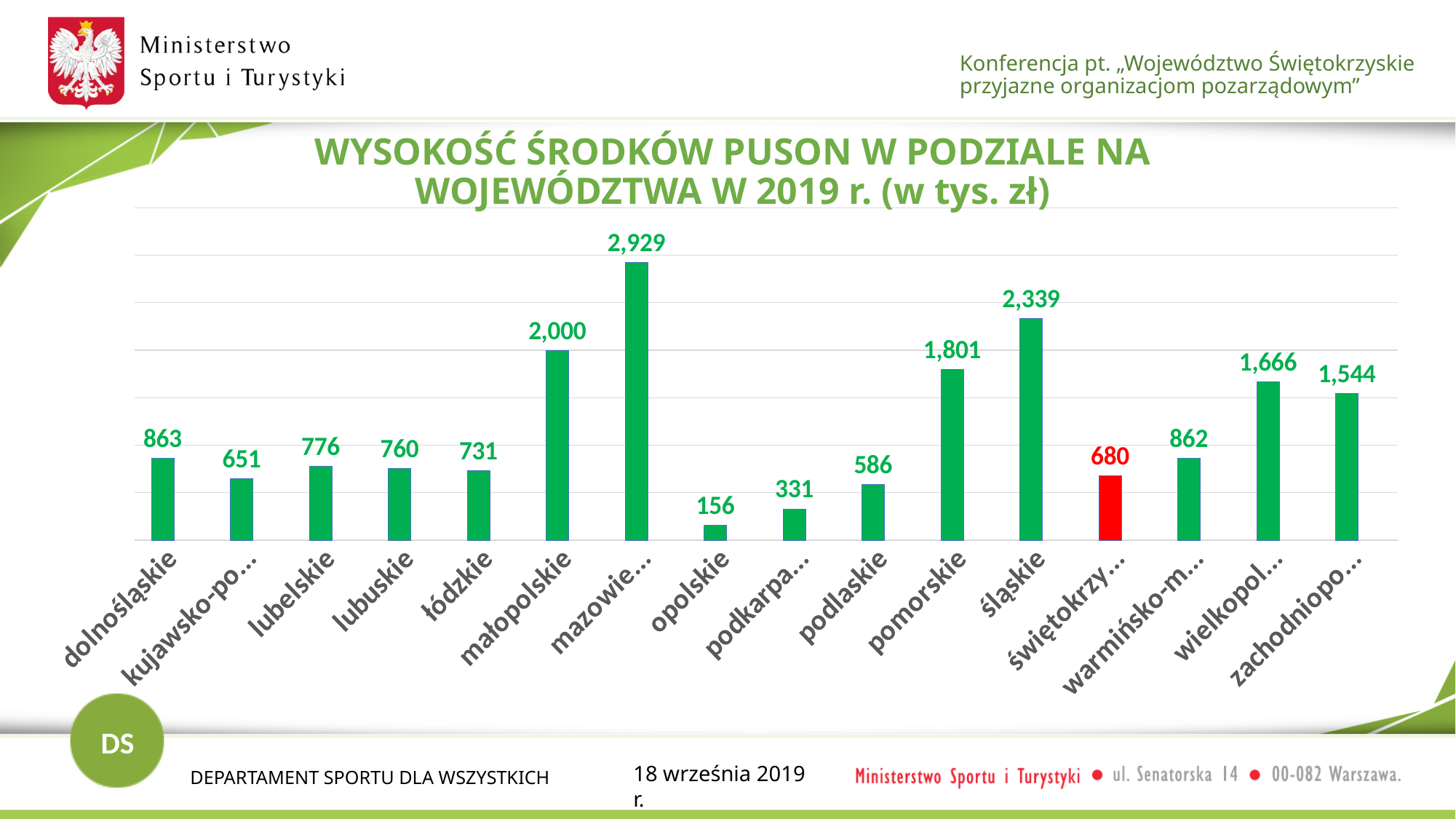
What is the value for śląskie? 2,339 What is the value for małopolskie? 2,000 What is the value for opolskie? 156 Which voivodeship has the lowest value? opolskie What is the difference between the values for śląskie and pomorskie? 538 What type of chart is shown on the slide? bar chart How many bars in the chart are coloured red? 1 What is the value for pomorskie? 1,801 Which has a larger value, lubelskie or łódzkie? lubelskie What is the difference between the values for dolnośląskie and podlaskie? 277 How many voivodeships (bars) are shown in the chart? 16 What is the value for dolnośląskie? 863